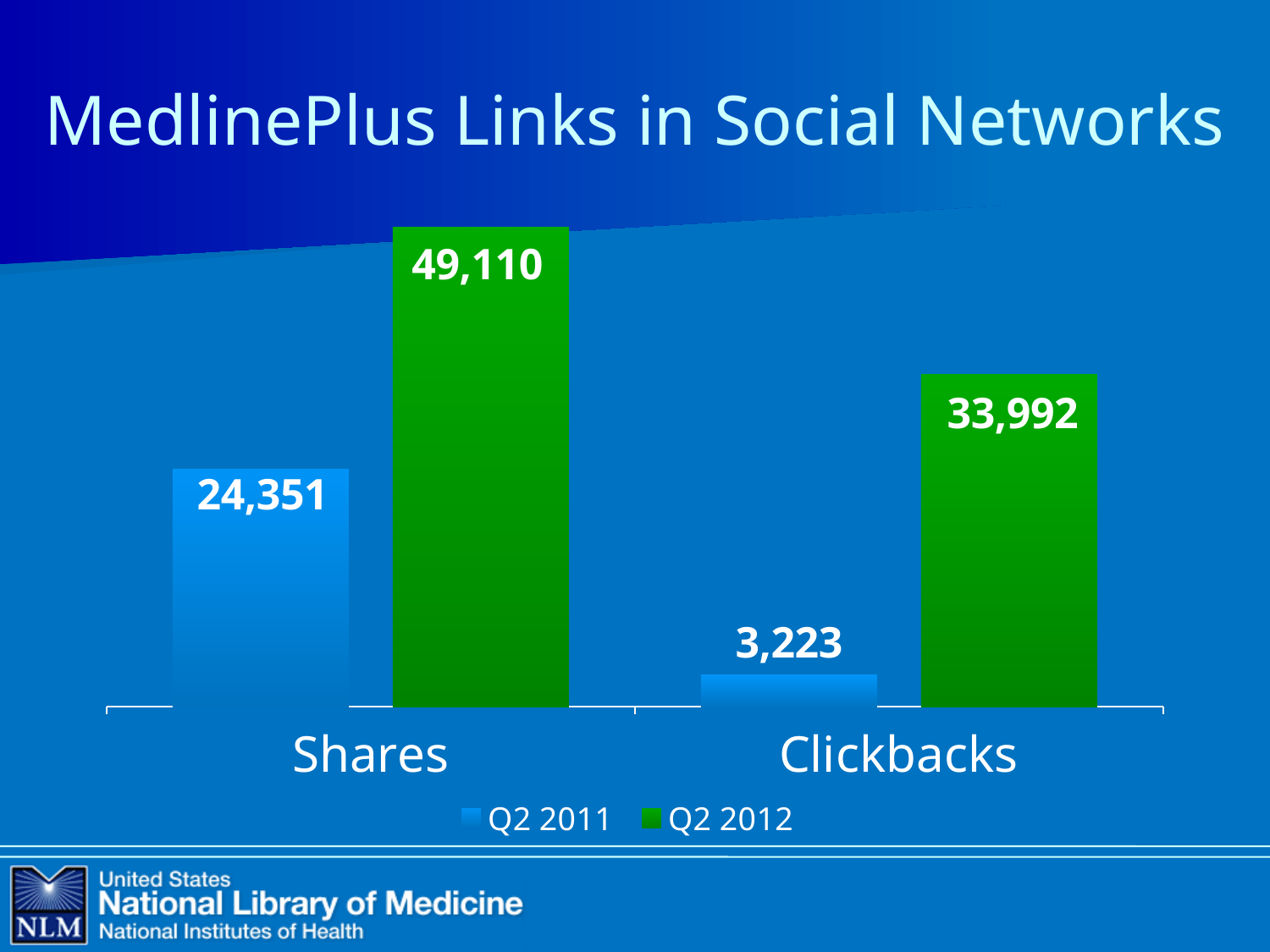
What is the value for Shares in Q2 2011? 24,351 What is the difference between the Q2 2012 and Q2 2011 values for Clickbacks? 30,769 What is the value for Shares in Q2 2012? 49,110 Which category has the lowest value in the Q2 2011 series? Clickbacks How many series does the legend list? 2 What is the difference between the Q2 2012 and Q2 2011 values for Shares? 24,759 How many categories are shown on the x axis? 2 Which is larger: Shares in Q2 2011 or Clickbacks in Q2 2012? Clickbacks in Q2 2012 What is the value for Clickbacks in Q2 2011? 3,223 Which category has the highest value in the Q2 2012 series? Shares What is the value for Clickbacks in Q2 2012? 33,992 What kind of chart is shown on the slide? Bar chart